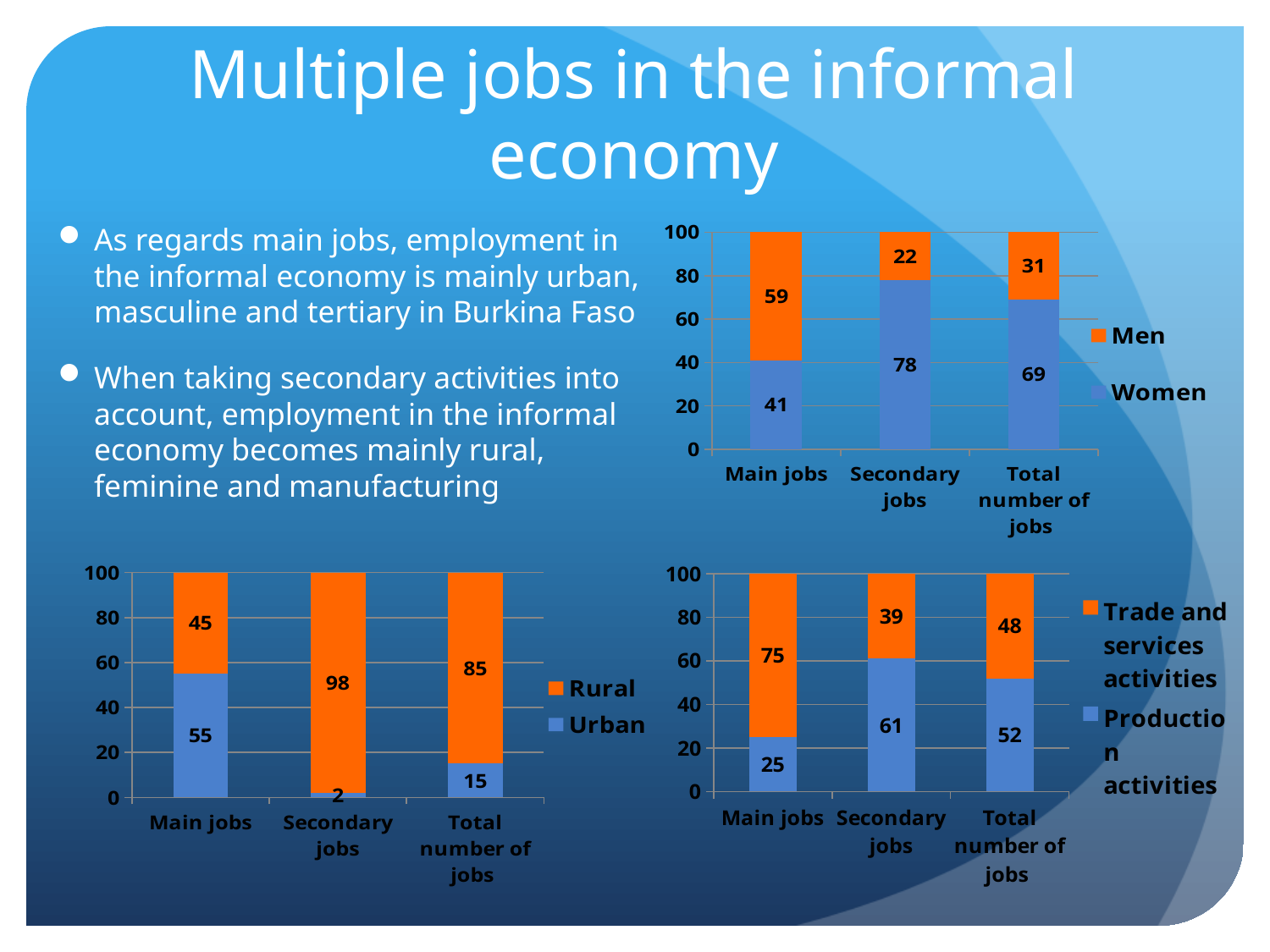
In the bottom-right chart (Trade and services / Production), how many categories are shown on the x axis? 3 In the top-right chart (Men/Women), what is the value for Women in Main jobs? 41 In the bottom-right chart (Trade and services / Production), what is the value for Production activities in Secondary jobs? 61 In the top-right chart (Men/Women), what is the value for Men in Secondary jobs? 22 In the bottom-left chart (Rural/Urban), which category has the lowest Urban value? Secondary jobs In the top-right chart (Men/Women), which category has the highest value for Women? Secondary jobs In the top-right chart (Men/Women), what is the total of the stacked bar for Total number of jobs? 100 In the bottom-left chart (Rural/Urban), how many series does the legend list? 2 In the bottom-left chart (Rural/Urban), what is the value for Rural in Secondary jobs? 98 What kind of chart is the top-right chart (Men/Women)? Stacked bar chart In the bottom-right chart (Trade and services / Production), is the value for Trade and services activities in Main jobs larger or smaller than the value for Production activities in Main jobs? larger In the bottom-left chart (Rural/Urban), what is the difference between the Urban values for Main jobs and Total number of jobs? 40